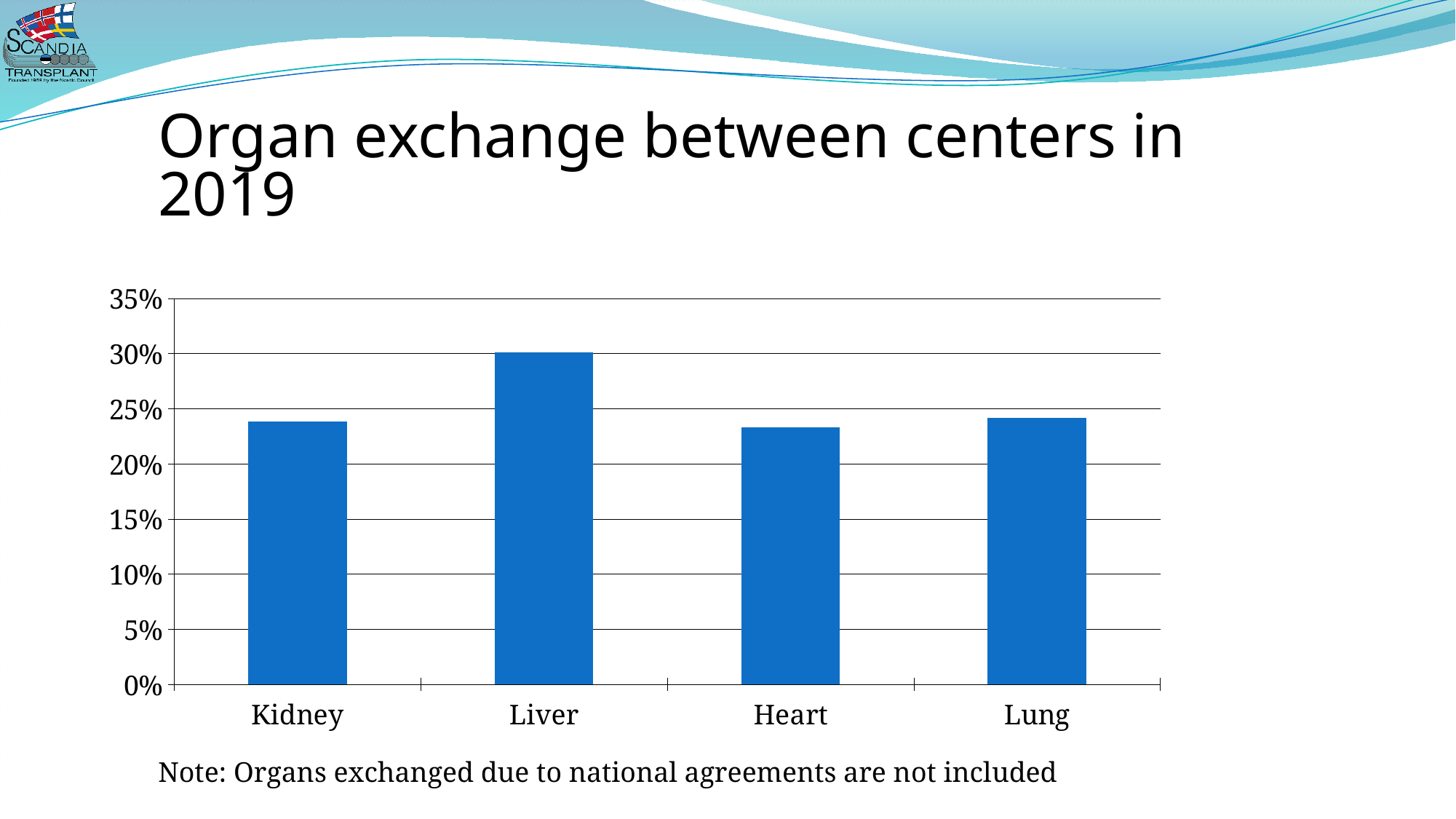
Which is larger, the value for Liver or the value for Heart? Liver Is the value for Heart greater or less than 25%? less Is the value for Kidney greater or less than 20%? greater Is the value for Lung greater or less than 20%? greater What is the highest value shown on the y axis of the chart? 35% What is the title of the slide containing the chart? Organ exchange between centers in 2019 Which is larger, the value for Kidney or the value for Liver? Liver Which organ has the highest share of exchange between centers? Liver What kind of chart is shown on the slide? bar chart How many organ categories are shown on the x axis? 4